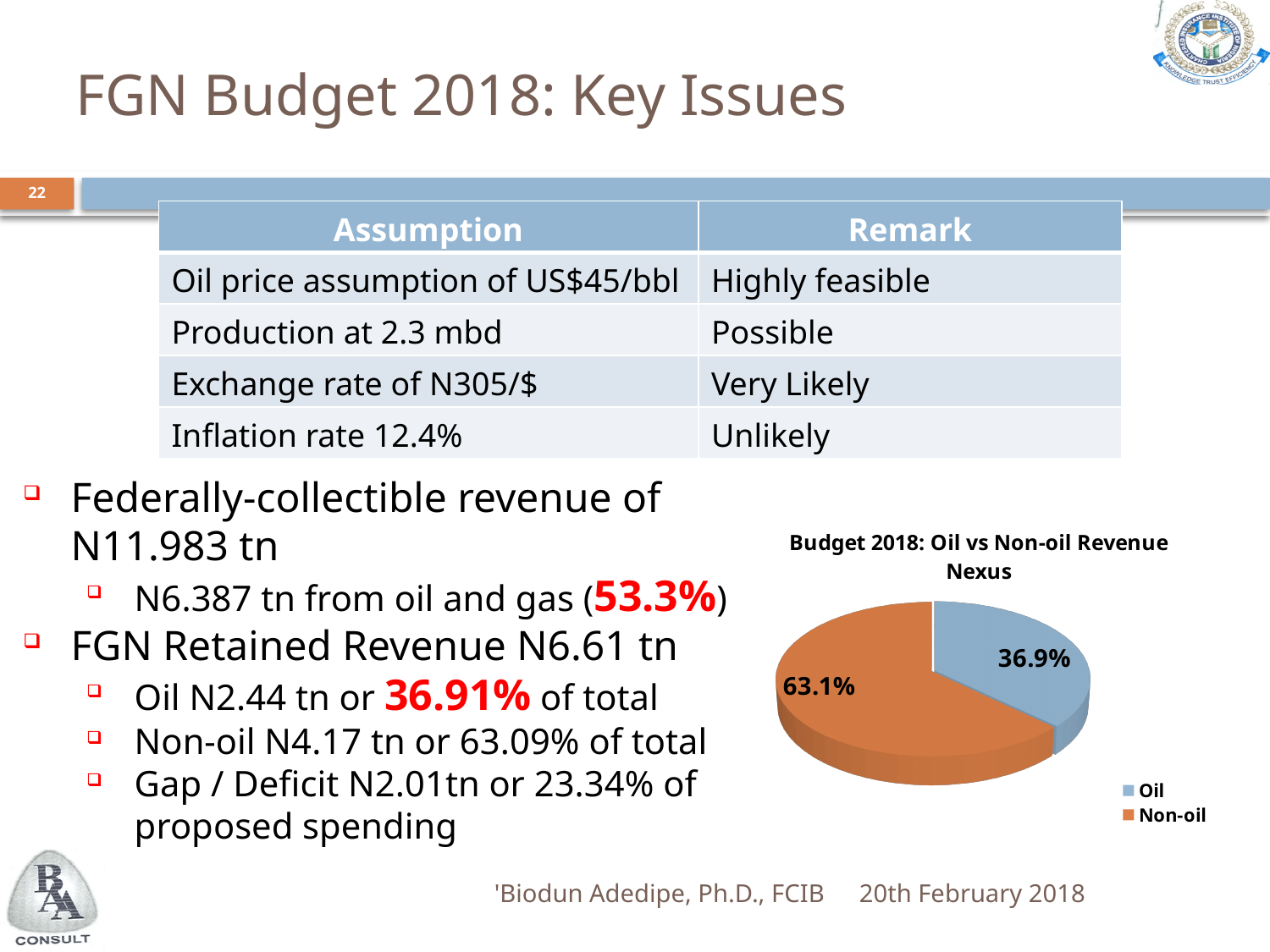
What is the title of the chart? Budget 2018: Oil vs Non-oil Revenue Nexus What is the difference in percentage points between the Non-oil and Oil slices? 26.2 Which slice of the pie is the largest? Non-oil Is the Oil slice greater or less than 50% of the pie? less What share of the pie does Non-oil represent? 63.1% What type of chart is shown on the slide? Pie chart What share of the pie does Oil represent? 36.9% How many entries does the chart legend list? 2 Which is larger, the Oil slice or the Non-oil slice? Non-oil Which slice of the pie is the smallest? Oil Which colour represents Non-oil in the pie chart? Orange How many slices does the pie chart have? 2